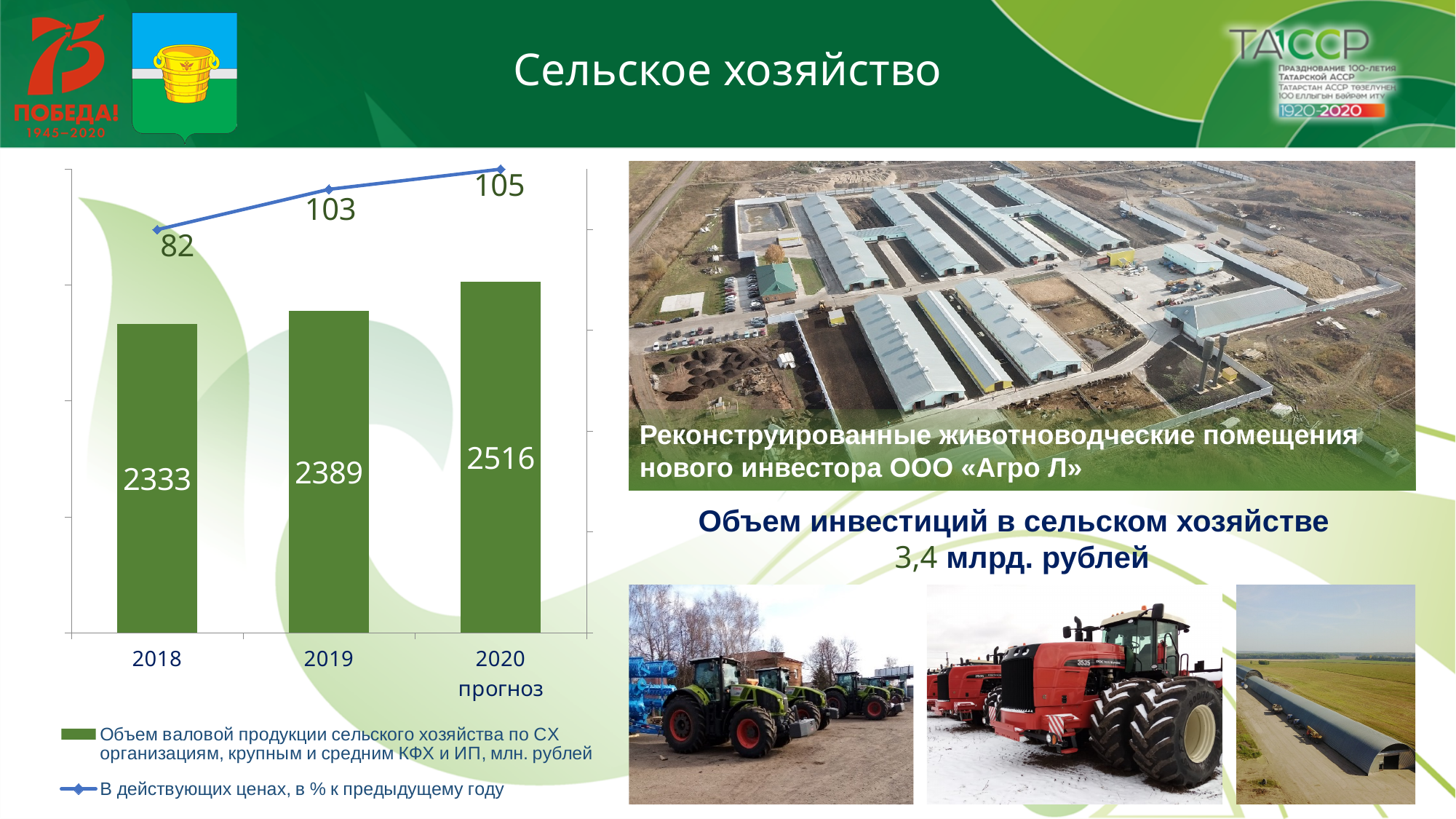
How many series does the chart's legend list? 2 Which is larger: the bar value for 2019 or the bar value for 2018? 2019 How many years (categories) are shown on the x axis of the chart? 3 Which year has the highest bar value in the chart? 2020 Which year has the lowest value on the line series in the chart? 2018 What is the value of the bar for 2019 in the chart? 2389 What is the value of the line series (в действующих ценах, в % к предыдущему году) for 2018? 82 What is the value of the bar for 2018 in the chart? 2333 What is the value of the line series (в действующих ценах, в % к предыдущему году) for 2020? 105 What is the difference between the line values for 2019 and 2018? 21 What is the difference between the bar values for 2020 and 2018? 183 What is the value of the bar for 2020 (прогноз) in the chart? 2516